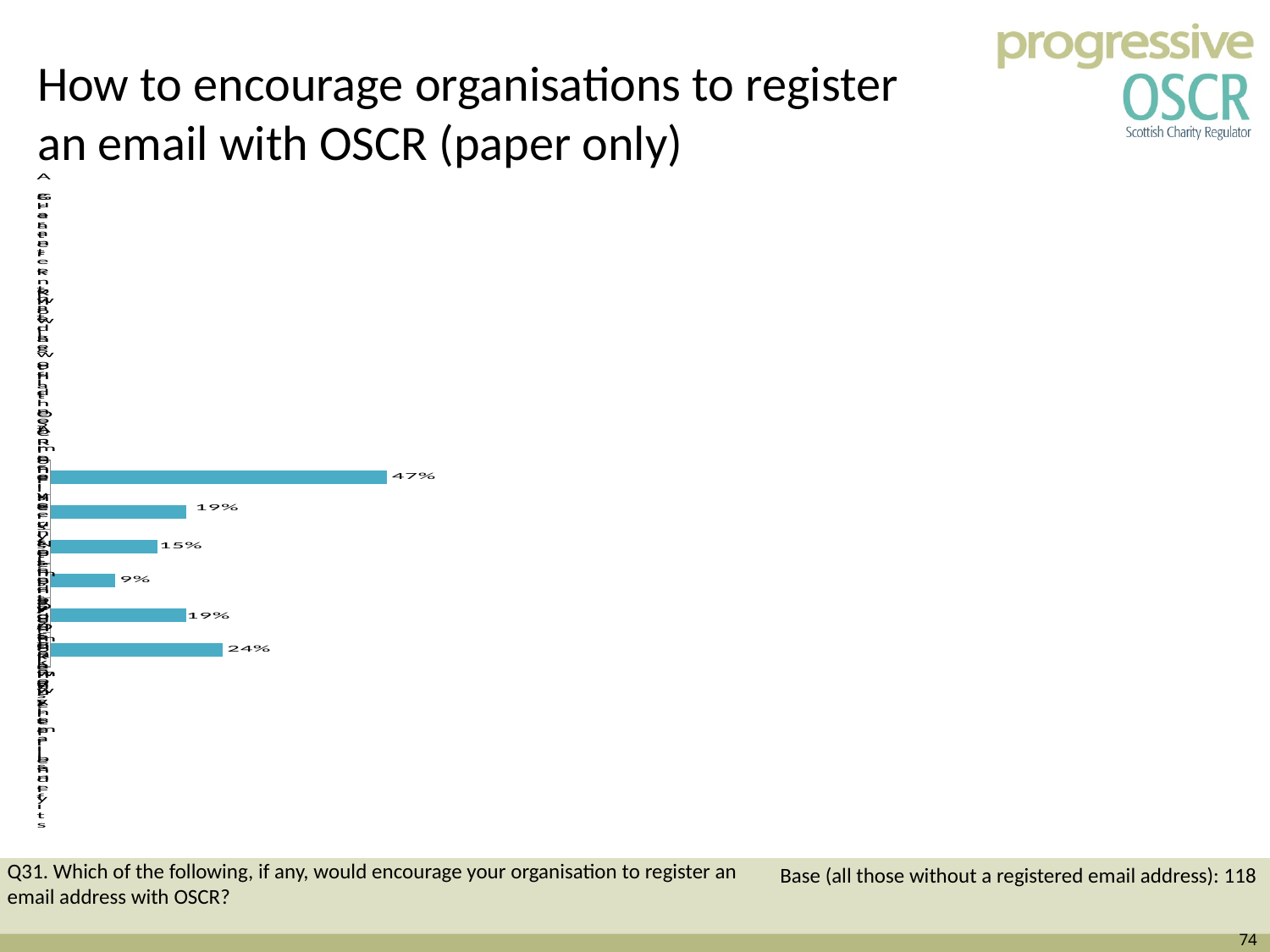
Which is larger: the value of the third bar from the top or the value of the bottom bar? the bottom bar How many bars in the chart show a value of 19%? 2 How many bars are plotted in the chart? 6 What is the value shown on the bottom bar of the chart? 24% What is the value shown on the top bar of the chart? 47% What is the base size stated below the chart? 118 What is the lowest value shown in the chart? 9% What is the value shown on the third bar from the top? 15% What is the difference between the top bar's value and the bottom bar's value? 23% What is the highest value shown in the chart? 47% What type of chart is shown on the slide? bar chart What is the value shown on the fourth bar from the top? 9%